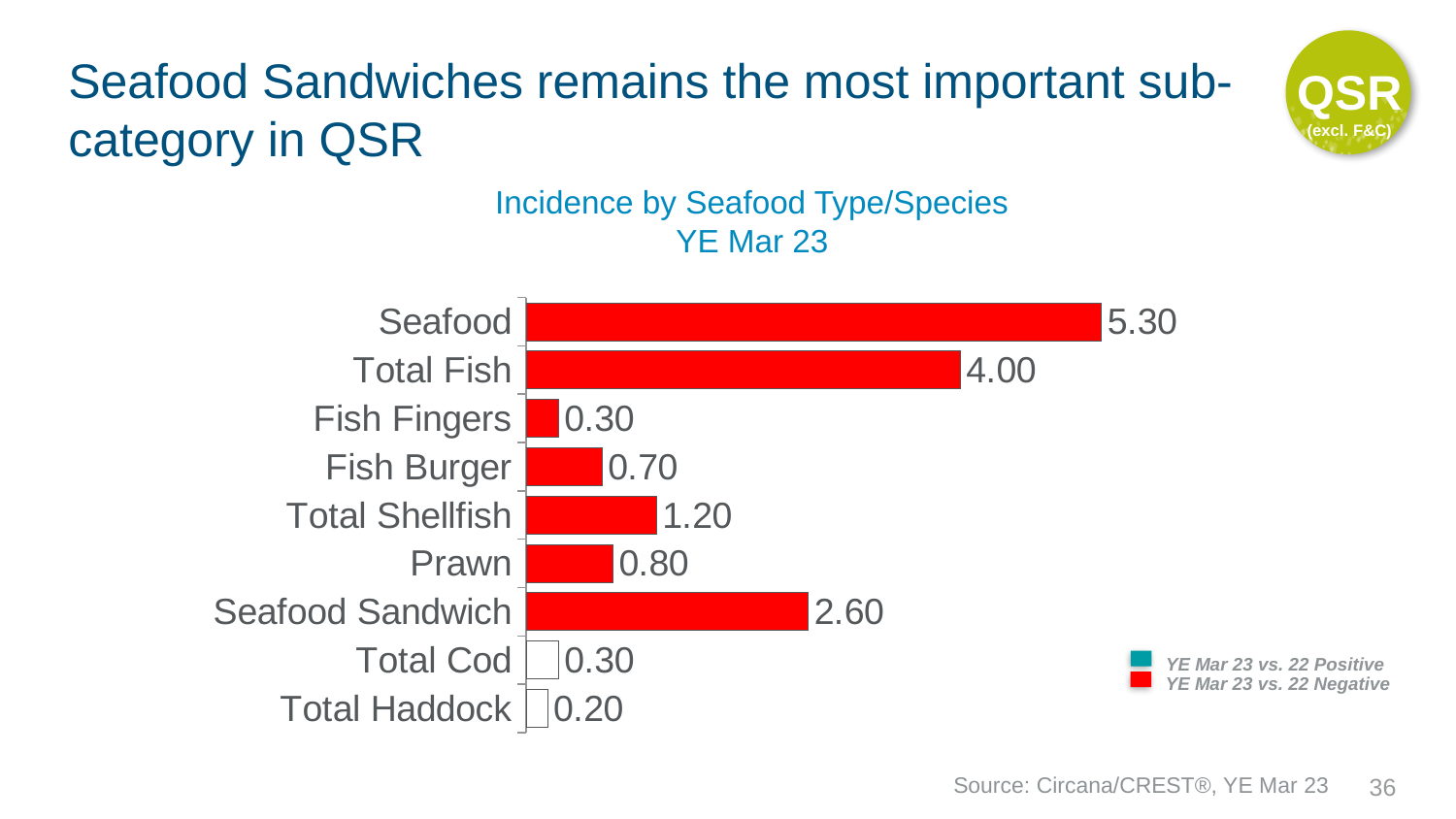
What is the difference between the values for Total Fish and Seafood Sandwich? 1.40 What is the value for Prawn? 0.80 Which category has the lowest value? Total Haddock Which is larger, the value for Total Shellfish or the value for Fish Burger? Total Shellfish What is the title of the chart? Incidence by Seafood Type/Species YE Mar 23 Which is larger, the value for Fish Burger or the value for Prawn? Prawn How many categories are shown in the chart? 9 Which category has the highest value? Seafood What is the value for Seafood Sandwich? 2.60 What is the value for Total Shellfish? 1.20 What is the difference between the values for Seafood and Total Fish? 1.30 What kind of chart is shown on the slide? Bar chart